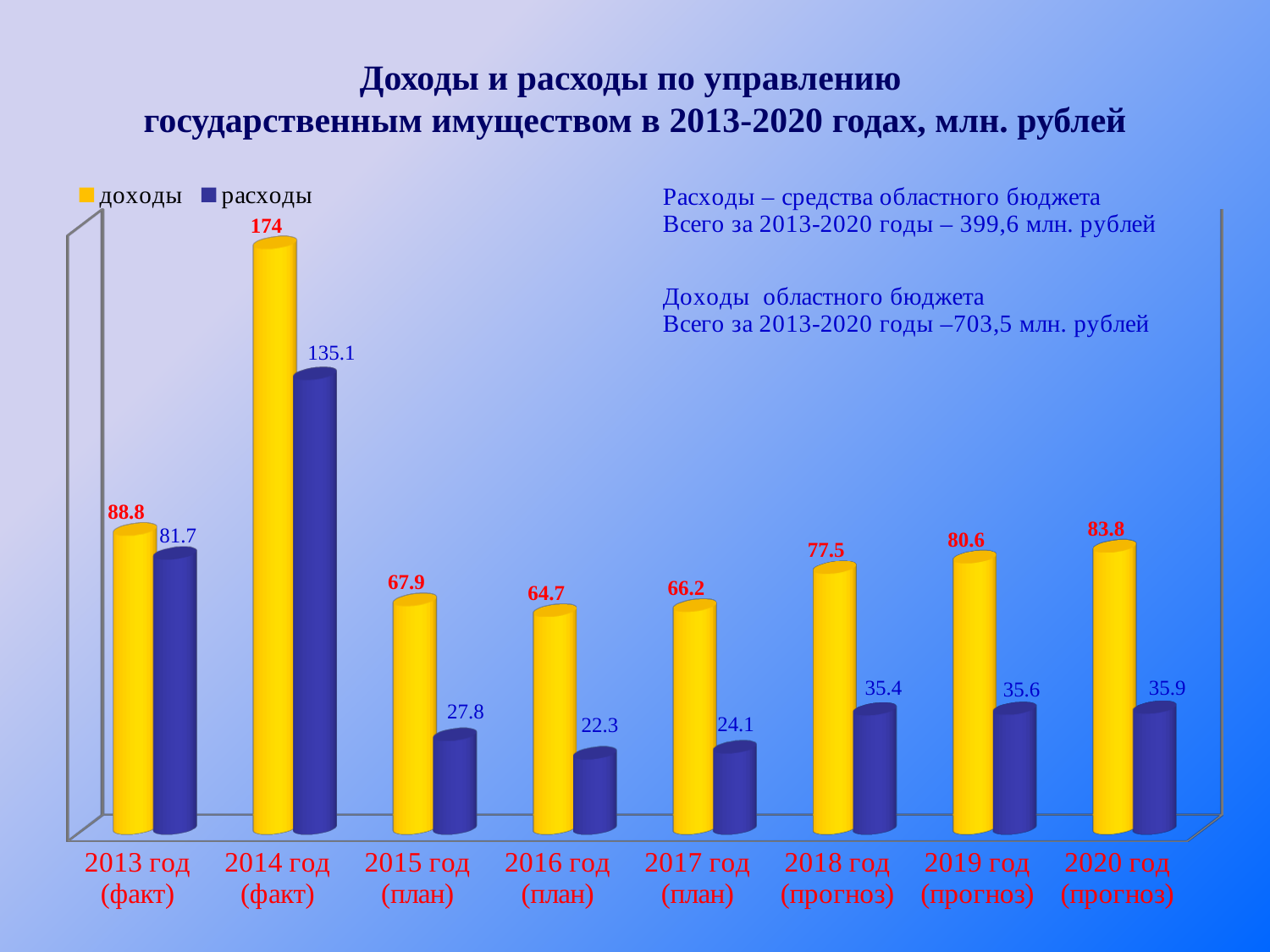
What kind of chart is shown on the slide? bar chart What is the value of расходы for 2016 год (план)? 22.3 Which is larger: расходы for 2015 год (план) or расходы for 2017 год (план)? 2015 год (план) How many series does the legend list? 2 Which year has the lowest value of доходы? 2016 год (план) Do the values of доходы rise or fall from 2017 год (план) to 2020 год (прогноз)? rise How many years (categories) are shown on the x axis? 8 What is the difference between доходы and расходы for 2013 год (факт)? 7.1 What is the value of доходы for 2014 год (факт)? 174 What is the value of доходы for 2019 год (прогноз)? 80.6 Which colour represents the series расходы in the chart? blue Which year has the highest value of расходы? 2014 год (факт)